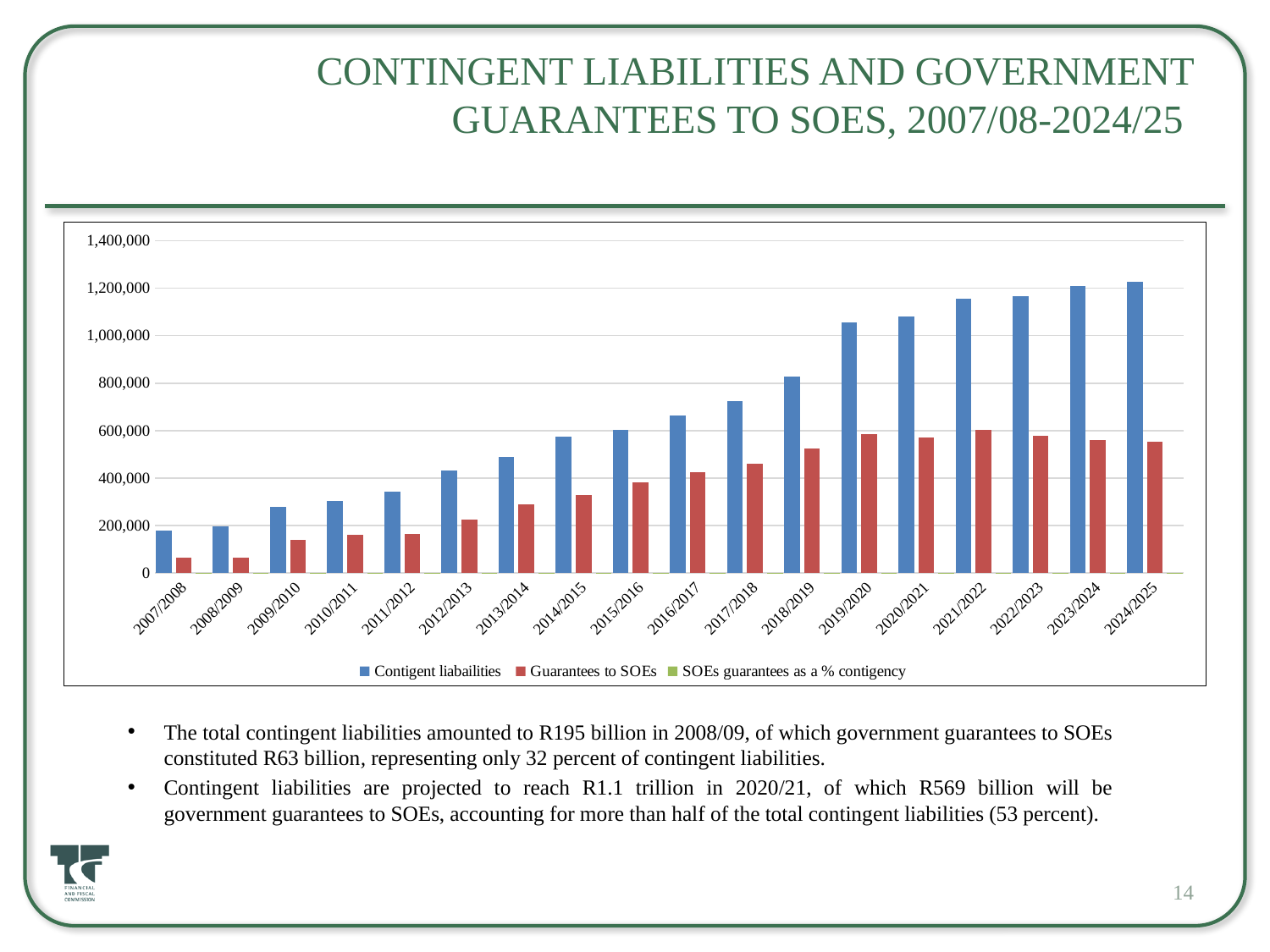
Is the value of Contingent liabilities for 2013/2014 greater or less than 400,000? greater Is the value of Guarantees to SOEs for 2007/2008 greater or less than 200,000? less Is the value of Guarantees to SOEs for 2021/2022 greater or less than 400,000? greater In 2020/2021, which is larger: Contingent liabilities or Guarantees to SOEs? Contingent liabilities What colour are the bars for Guarantees to SOEs? red How many series does the chart legend list? 3 In which year are Contingent liabilities highest? 2024/2025 How many fiscal years are shown on the x axis of the chart? 18 In which year are Contingent liabilities lowest? 2007/2008 Do Contingent liabilities rise or fall from 2007/2008 to 2024/2025? rise What kind of chart is shown on the slide? bar chart